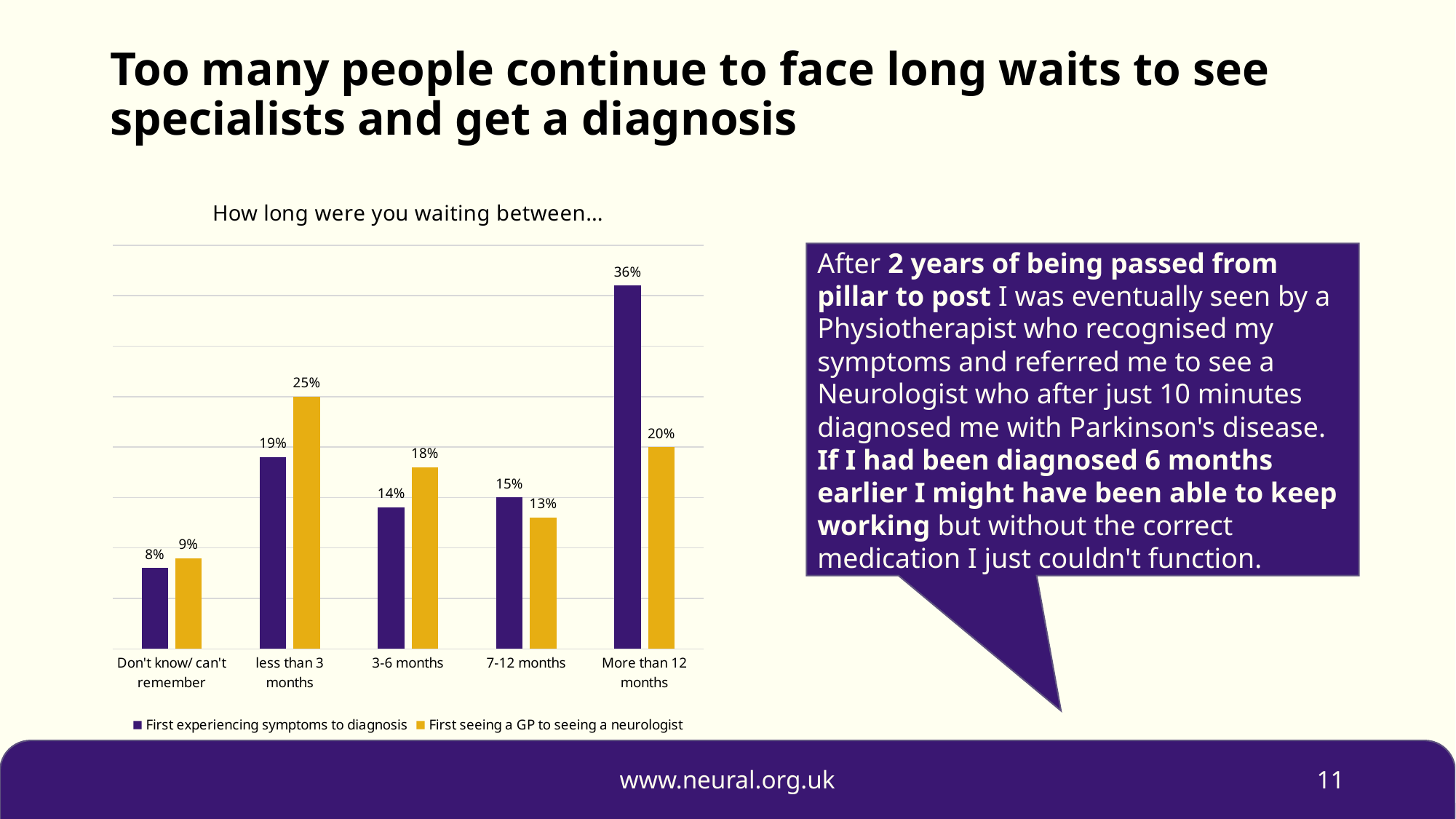
What is the difference between the two series for the 'More than 12 months' category? 16% How many series does the chart's legend list? 2 Which category has the lowest value for 'First seeing a GP to seeing a neurologist'? Don't know/ can't remember What percentage of respondents waited more than 12 months between first experiencing symptoms and diagnosis? 36% What is the value for '3-6 months' in the 'First experiencing symptoms to diagnosis' series? 14% Which category has the highest value for 'First experiencing symptoms to diagnosis'? More than 12 months For '7-12 months', which series has the larger value? First experiencing symptoms to diagnosis What type of chart is shown on the slide? Bar chart What percentage waited less than 3 months between first seeing a GP and seeing a neurologist? 25% How many categories are shown on the x axis of the chart? 5 What is the title of the chart? How long were you waiting between... Which colour represents the 'First seeing a GP to seeing a neurologist' series? Yellow